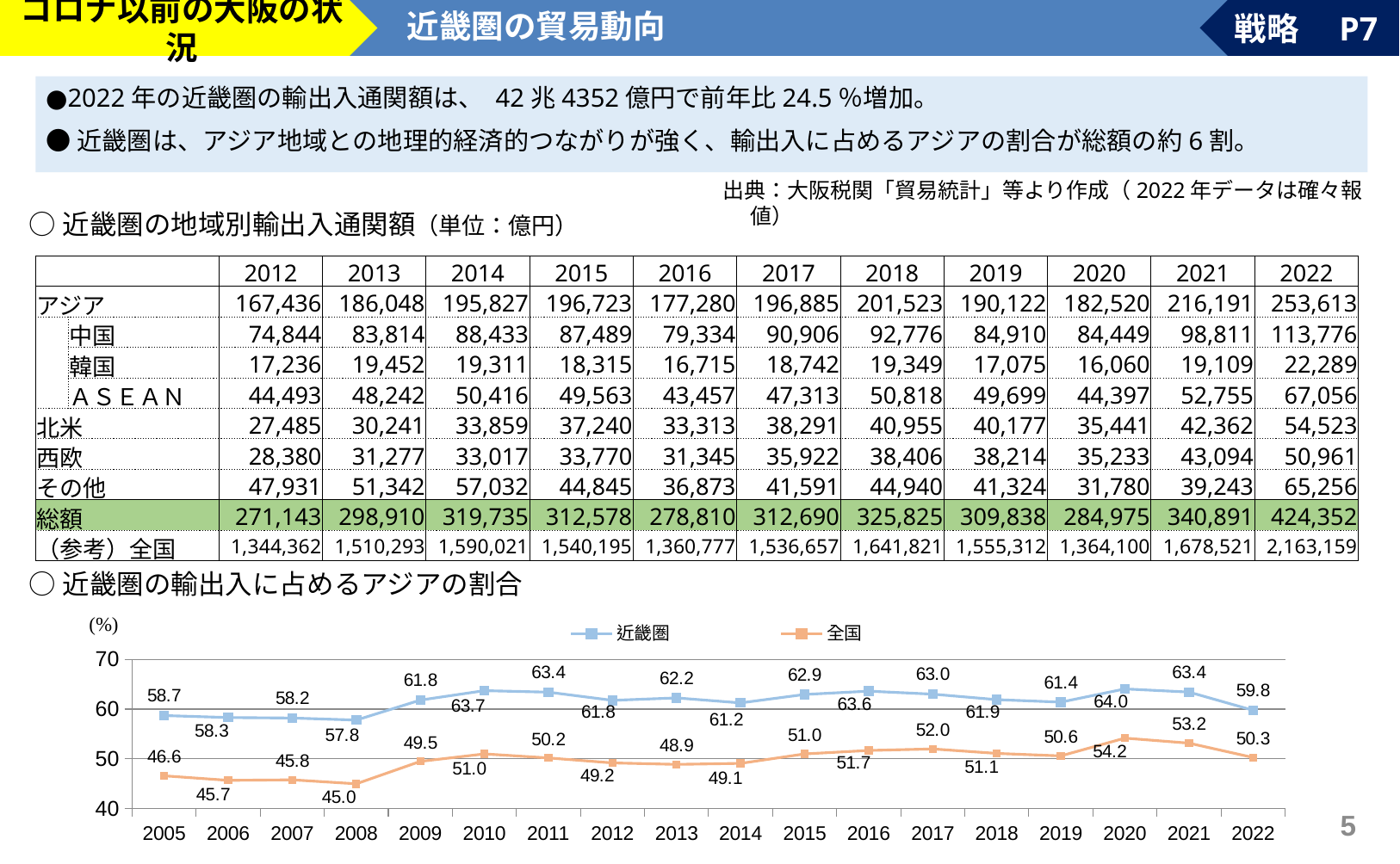
What kind of chart is 近畿圏の輸出入に占めるアジアの割合? line chart In the chart 近畿圏の輸出入に占めるアジアの割合, is the value for 全国 in 2008 greater or less than 50? less In the chart 近畿圏の輸出入に占めるアジアの割合, what is the value for 近畿圏 in 2022? 59.8 In the chart 近畿圏の輸出入に占めるアジアの割合, what is the value for 全国 in 2005? 46.6 In the chart 近畿圏の輸出入に占めるアジアの割合, what is the difference between the 近畿圏 and 全国 values in 2022? 9.5 In the chart 近畿圏の輸出入に占めるアジアの割合, does the 近畿圏 value rise or fall from 2020 to 2022? fall How many years are shown on the x axis of the chart 近畿圏の輸出入に占めるアジアの割合? 18 In the chart 近畿圏の輸出入に占めるアジアの割合, in which year is the 全国 value lowest? 2008 How many series does the legend of the chart 近畿圏の輸出入に占めるアジアの割合 list? 2 In the chart 近畿圏の輸出入に占めるアジアの割合, what is the value for 全国 in 2017? 52.0 In the chart 近畿圏の輸出入に占めるアジアの割合, which series has the larger value in 2010, 近畿圏 or 全国? 近畿圏 In the chart 近畿圏の輸出入に占めるアジアの割合, in which year is the 近畿圏 value highest? 2020